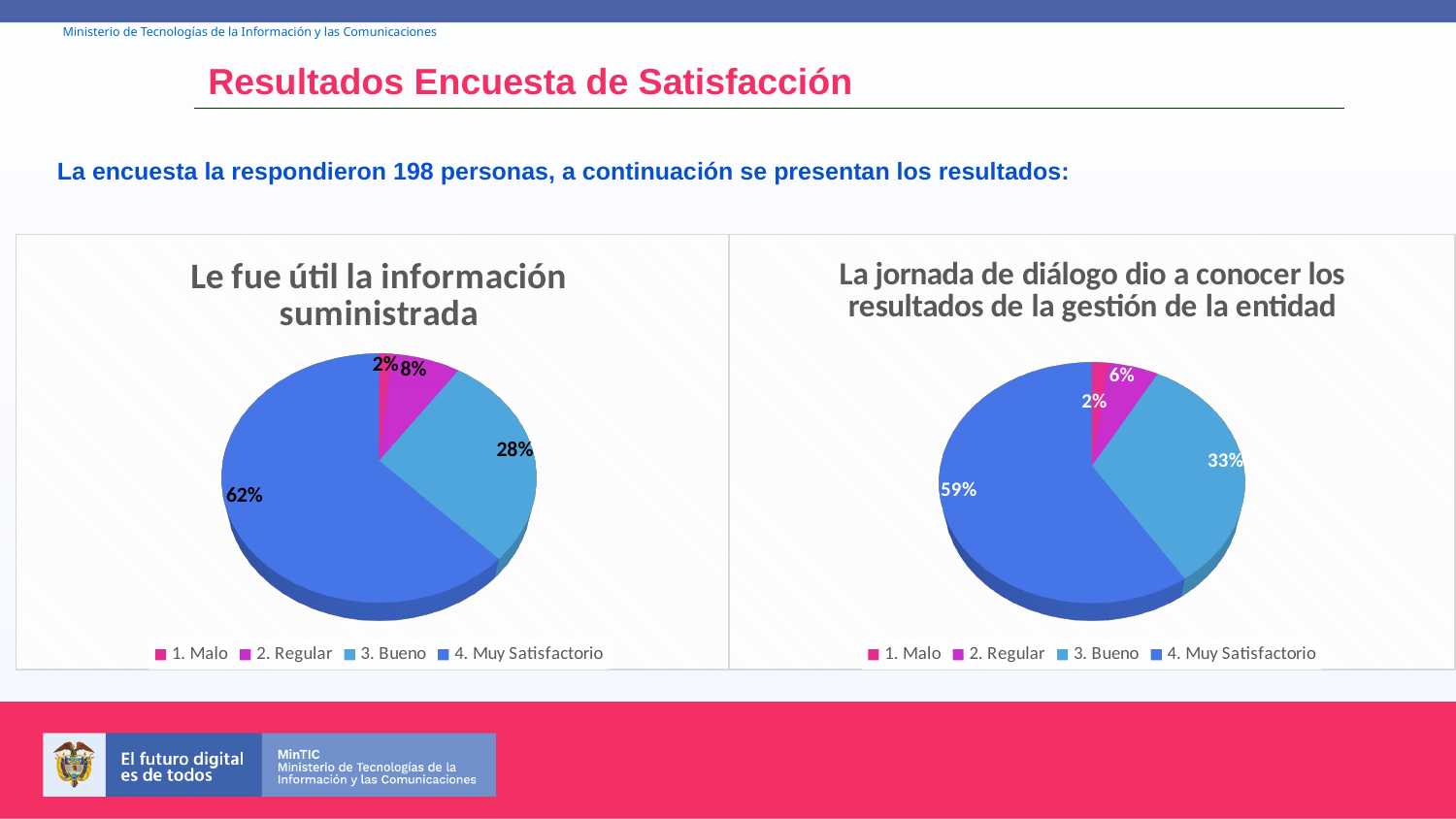
In the chart titled "La jornada de diálogo dio a conocer los resultados de la gestión de la entidad", what share is labelled for 2. Regular? 6% Which chart has the larger share for 3. Bueno, the left chart or the right chart? The right chart In the chart titled "La jornada de diálogo dio a conocer los resultados de la gestión de la entidad", what is the difference between the 4. Muy Satisfactorio and 3. Bueno shares? 26% What type of chart is used on the slide? Pie chart In the chart titled "Le fue útil la información suministrada", what share is labelled for 2. Regular? 8% How many categories does the legend of the left chart list? 4 In the chart titled "La jornada de diálogo dio a conocer los resultados de la gestión de la entidad", what share is labelled for 3. Bueno? 33% In the chart titled "Le fue útil la información suministrada", which category has the smallest slice? 1. Malo In the chart titled "Le fue útil la información suministrada", which category has the largest slice? 4. Muy Satisfactorio